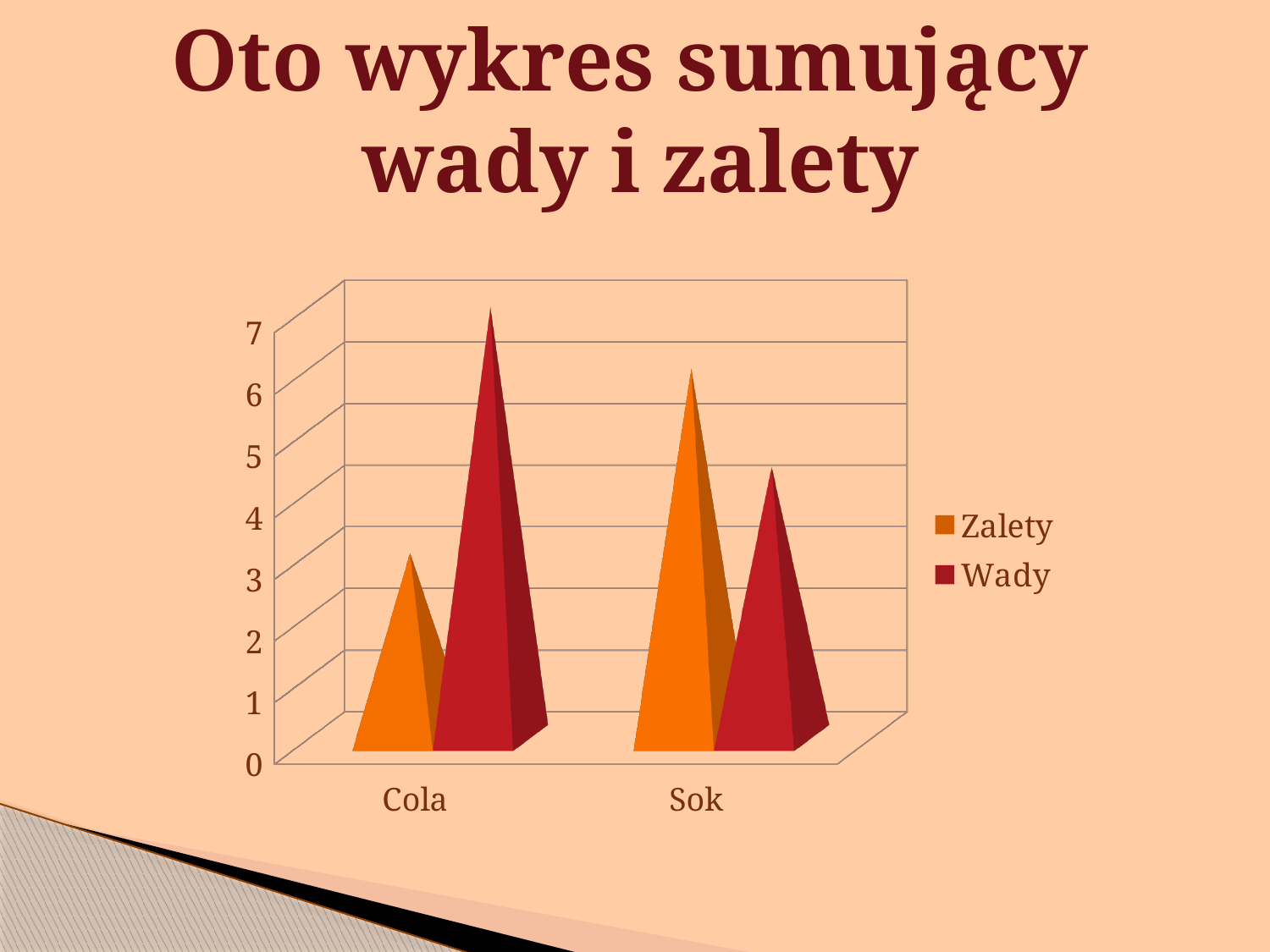
What kind of chart is shown on the slide? bar chart Is the Wady value for Sok greater or less than 6? less Is the Wady value for Cola greater or less than 5? greater For Cola, which is larger: Zalety or Wady? Wady Is the Zalety value for Cola greater or less than 4? less For Sok, which is larger: Zalety or Wady? Zalety What are the two series named in the chart's legend? Zalety and Wady Which bar is the lowest in the chart? Zalety for Cola Which category has the tallest bar in the chart? Cola (Wady) How many series does the chart's legend list? 2 How many categories are shown on the x axis of the chart? 2